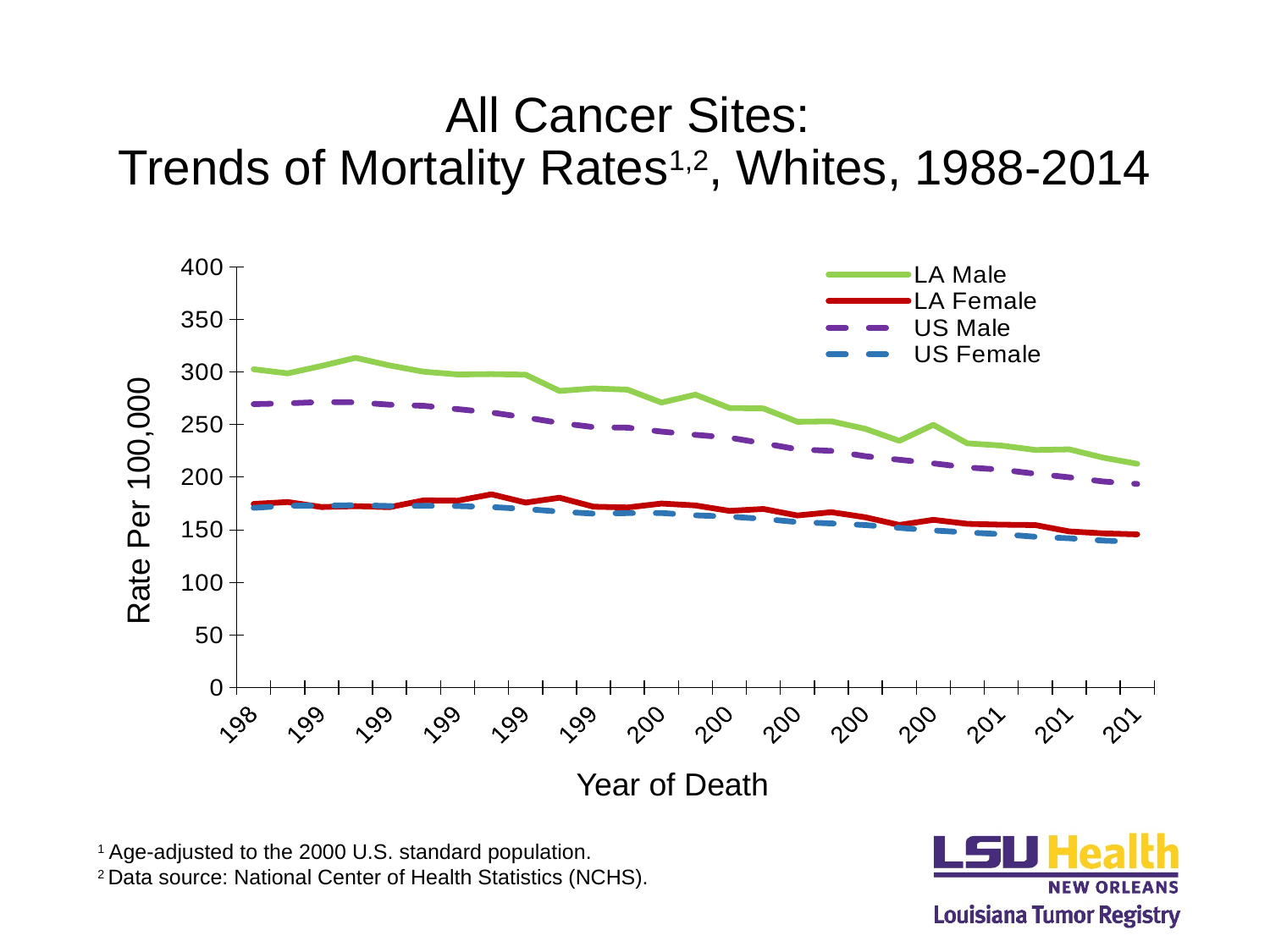
Does the US Male mortality rate rise or fall over the period shown? fall Is the US Male value at the start of the period greater or less than 250? greater Does the LA Male mortality rate rise or fall from 1988 to 2014? fall How many series does the legend list? 4 At the start of the period, which is higher, LA Male or US Male? LA Male What kind of chart is shown on the slide? line chart What is the label of the y axis? Rate Per 100,000 Is the LA Male value at the end of the period greater or less than 200? greater Is the LA Female value at the start of the period greater or less than 200? less Which series are listed in the legend? LA Male, LA Female, US Male, US Female Which series has the lowest mortality rate at the end of the period? US Female Which series has the highest mortality rate across the whole period? LA Male